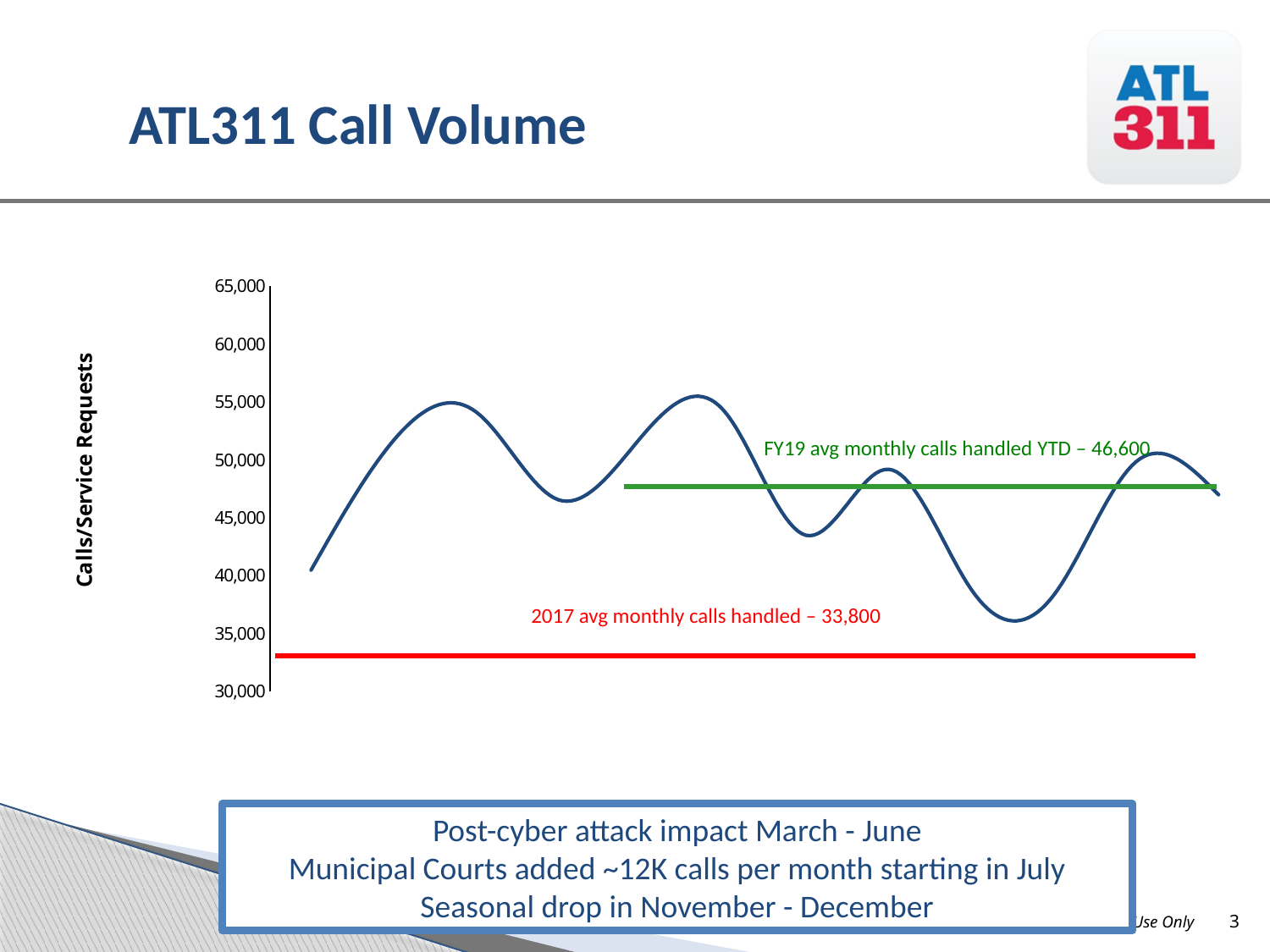
What is the FY19 average monthly calls handled YTD shown on the chart? 46,600 Is the highest point on the call volume line greater or less than 60,000? less What is the 2017 average monthly calls handled shown on the chart? 33,800 Which is larger, the FY19 YTD average monthly calls handled or the 2017 average monthly calls handled? FY19 YTD average (46,600) What is the difference between the FY19 YTD average monthly calls handled and the 2017 average monthly calls handled? 12,800 What is the title of the chart on the slide? ATL311 Call Volume What is the lowest value shown on the vertical axis of the chart? 30,000 Is the lowest point on the call volume line greater or less than 40,000? less What is the label on the vertical axis of the chart? Calls/Service Requests Is the highest point on the call volume line greater or less than 50,000? greater What kind of chart is shown on the slide? Line chart What is the highest value shown on the vertical axis of the chart? 65,000